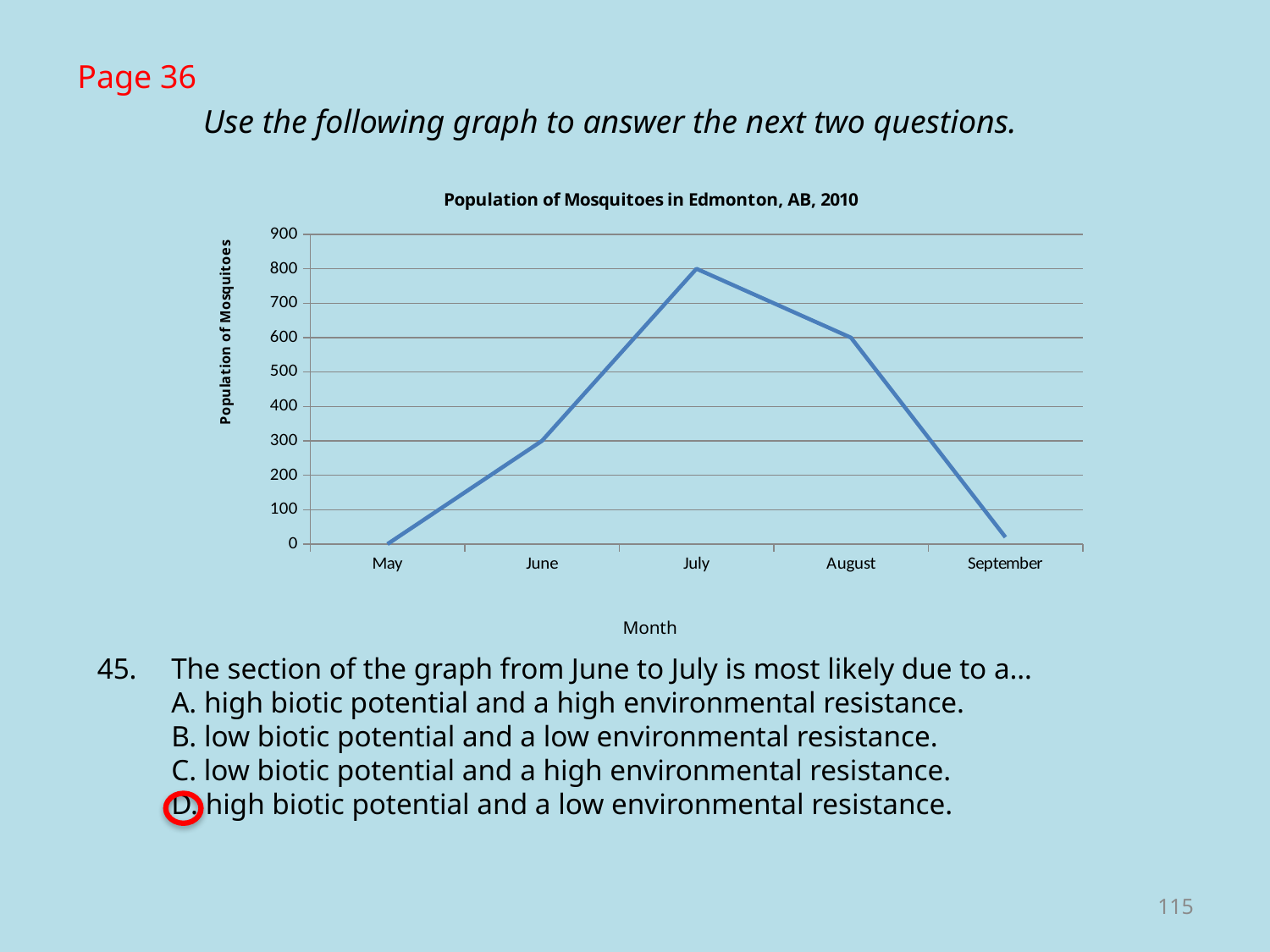
What is the population of mosquitoes in July? 800 Does the mosquito population rise or fall from July to September? fall What kind of chart is shown on the slide? line chart How many months are plotted on the x axis of the chart? 5 What is the population of mosquitoes in August? 600 Is the mosquito population in September greater or less than 100? less What is the population of mosquitoes in May? 0 Which month has the highest mosquito population? July What is the population of mosquitoes in June? 300 What is the title of the chart? Population of Mosquitoes in Edmonton, AB, 2010 What is the difference between the mosquito population in July and in June? 500 Which month has a larger mosquito population, June or August? August